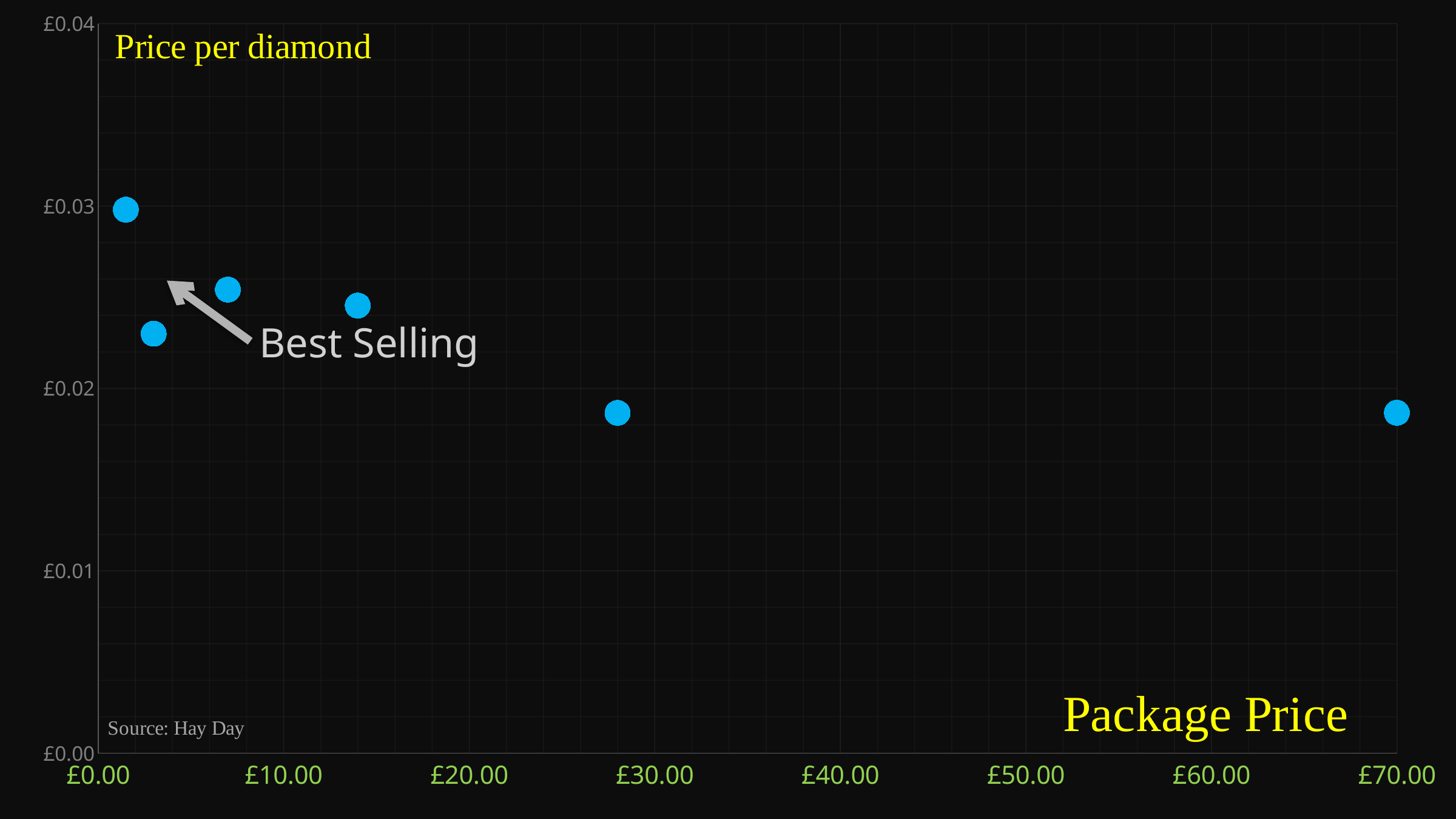
What is the label on the vertical axis of the chart? Price per diamond Overall, does the price per diamond rise or fall as the package price increases? Falls Is the price per diamond for the point at about £70.00 package price greater or less than £0.02? less How many points have a price per diamond above £0.02? 4 Is the price per diamond for the point labelled 'Best Selling' greater or less than £0.02? greater What is the label on the horizontal axis of the chart? Package Price Is the price per diamond for the point at about £30.00 package price greater or less than £0.02? less How many data points are plotted on the chart? 6 Which point has the highest price per diamond: the leftmost point or the rightmost point? The leftmost point What kind of chart is shown on the slide? Scatter chart